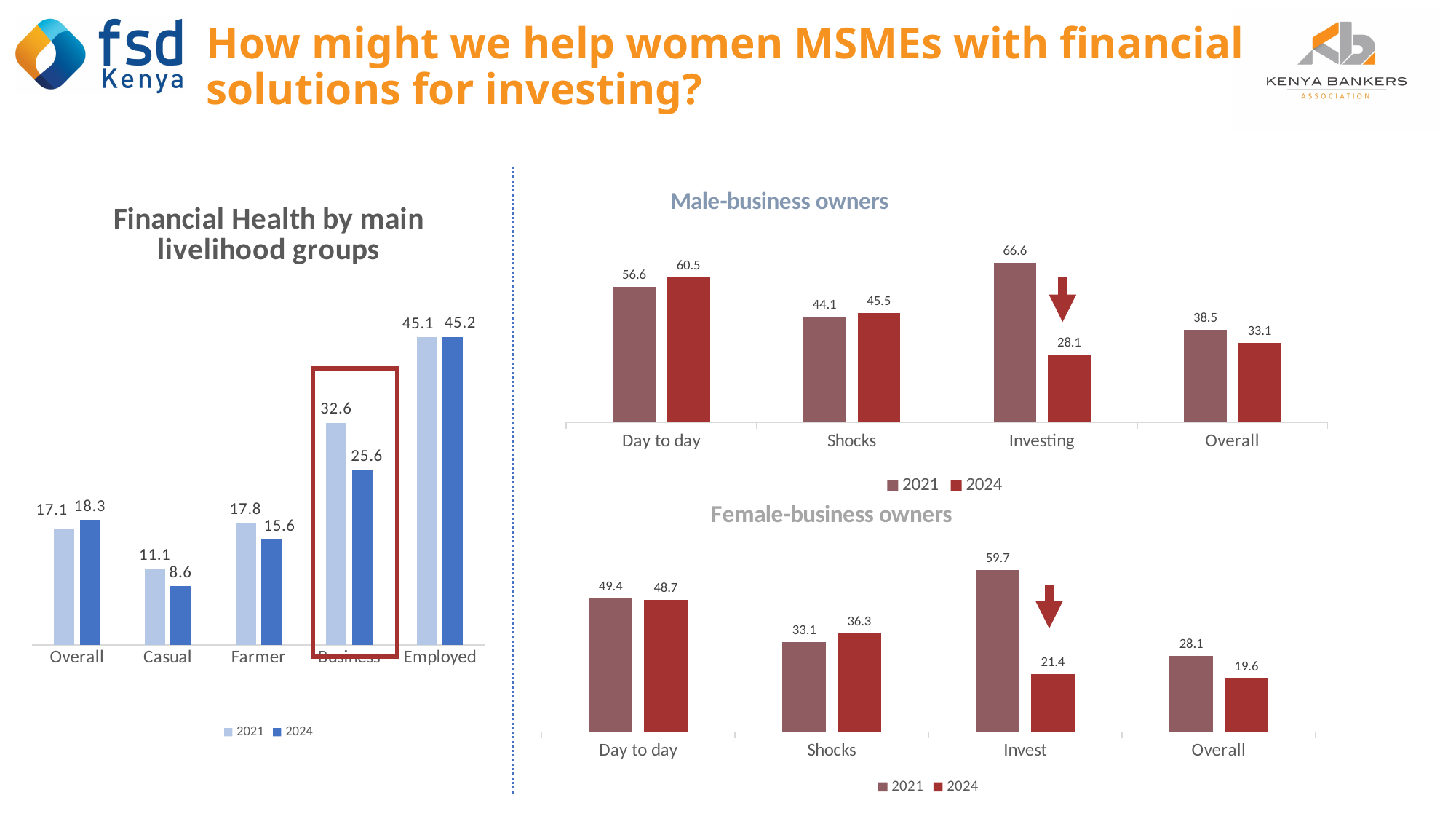
In the 'Male-business owners' chart, what is the 2021 value for Investing? 66.6 What kind of chart is the 'Male-business owners' chart? Bar chart In the 'Financial Health by main livelihood groups' chart, what is the 2024 value for Business? 25.6 In the 'Financial Health by main livelihood groups' chart, how many livelihood categories are shown on the x axis? 5 In the 'Female-business owners' chart, what is the 2024 value for Invest? 21.4 In the 'Financial Health by main livelihood groups' chart, which category has the lowest 2024 value? Casual In the 'Male-business owners' chart, what is the difference between the 2021 and 2024 values for Investing? 38.5 In the 'Female-business owners' chart, which is larger for Shocks: the 2021 value or the 2024 value? 2024 In the 'Financial Health by main livelihood groups' chart, what is the difference between the 2021 and 2024 values for Business? 7.0 How many series does the legend of the 'Female-business owners' chart list? 2 In the 'Male-business owners' chart, which category has the highest 2024 value? Day to day In the 'Female-business owners' chart, what is the difference between the 2021 and 2024 values for Overall? 8.5